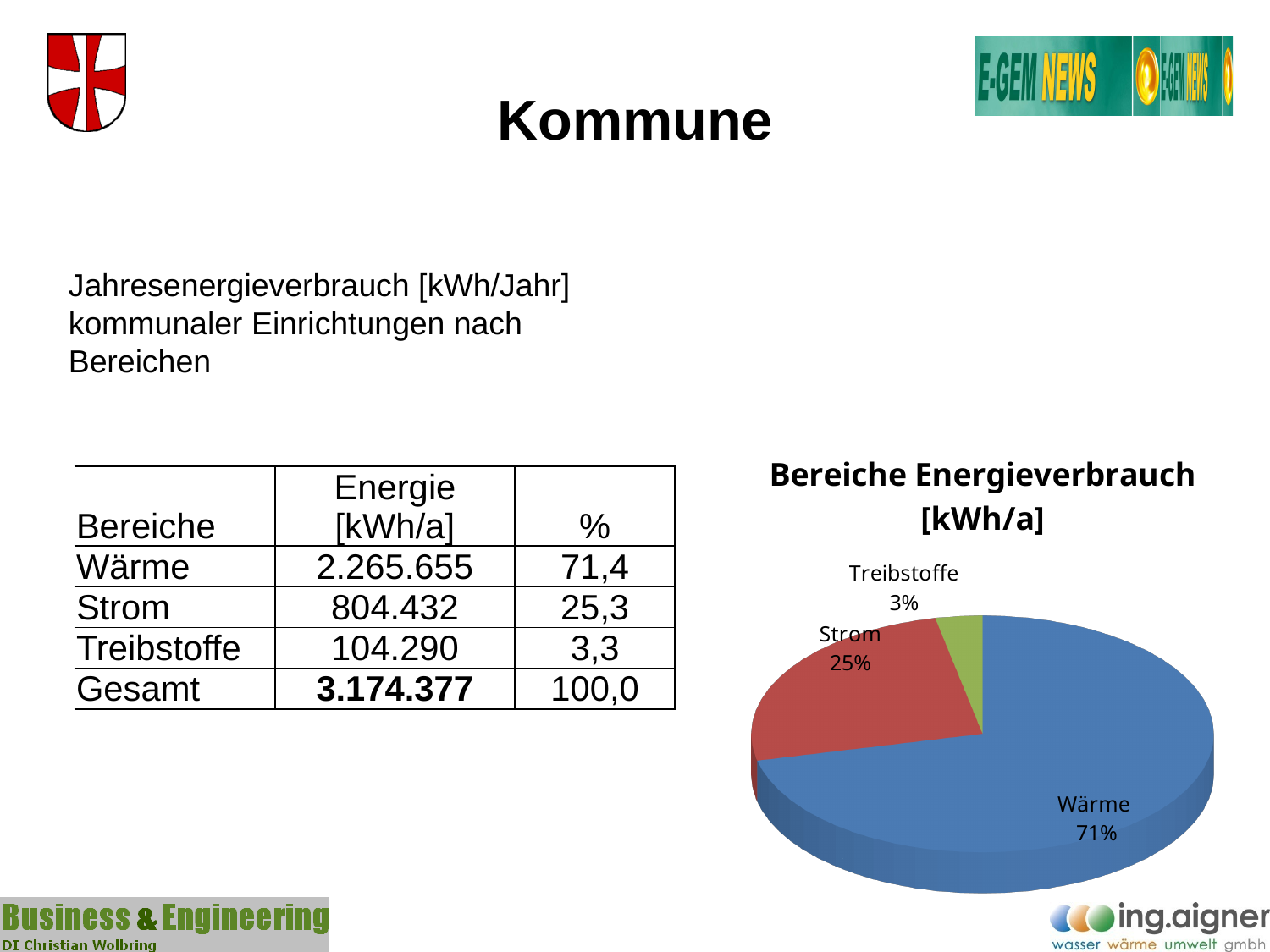
What colour is the Wärme slice? blue What is the difference in percentage points between the Wärme and Strom slices? 46% What is the title of the chart? Bereiche Energieverbrauch [kWh/a] Which category has the smallest slice of the pie? Treibstoffe What share of the pie does Strom have? 25% Which category has the largest slice of the pie? Wärme What type of chart is shown on the slide? pie chart What share of the pie does Wärme have? 71% What share of the pie does Treibstoffe have? 3% How many slices does the pie chart have? 3 Is the share for Wärme greater or less than 50%? greater Which slice is larger, Strom or Treibstoffe? Strom